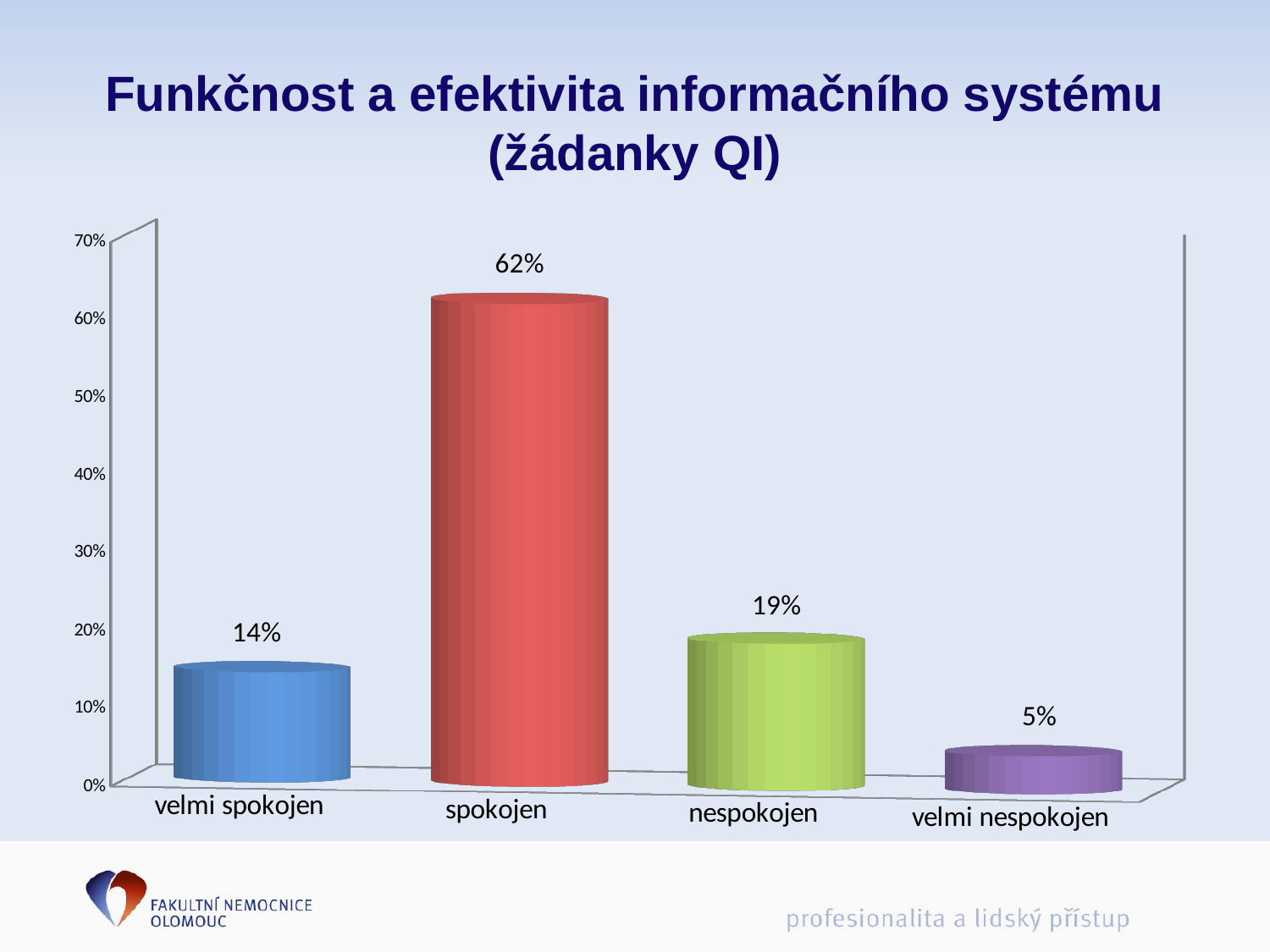
Which category has the lowest value? velmi nespokojen What is the value for "velmi spokojen"? 14% Is the value for "spokojen" greater or less than 50%? greater How many categories are shown on the x axis? 4 What is the value for "velmi nespokojen"? 5% What is the difference between the values for "spokojen" and "nespokojen"? 43% Which category has the highest value? spokojen What is the value for "nespokojen"? 19% What kind of chart is shown on the slide? bar chart Which is larger, the value for "nespokojen" or the value for "velmi spokojen"? nespokojen What is the title of the slide? Funkčnost a efektivita informačního systému (žádanky QI) What is the value for "spokojen"? 62%